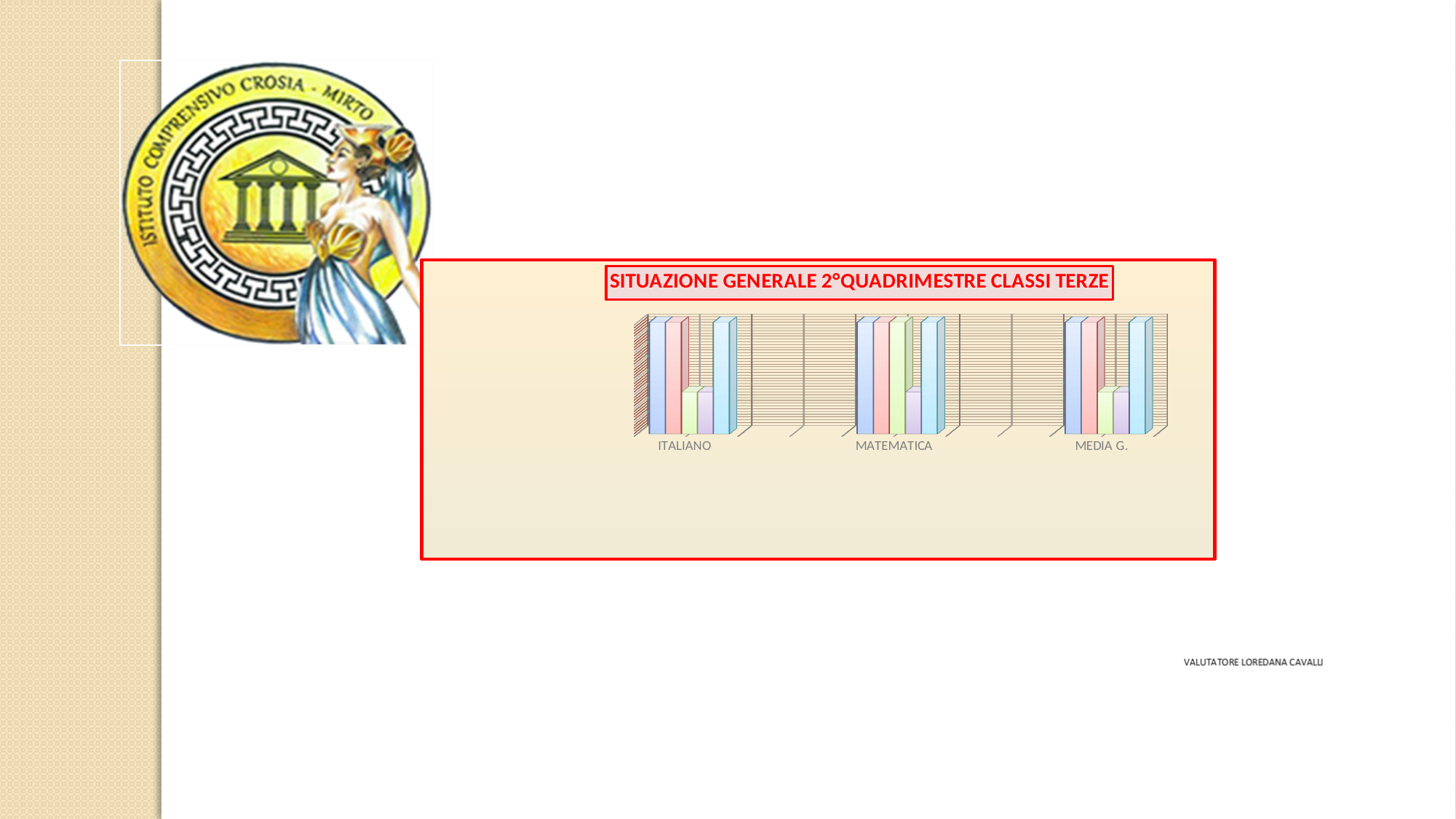
Which category is labelled in the middle of the x axis? MATEMATICA In the MATEMATICA group, is the purple bar taller or shorter than the pink bar? shorter In the MEDIA G. group, is the light blue bar on the right taller or shorter than the green bar? taller How many categories are shown on the x axis of the chart? 3 How many bars are plotted for each category in the chart? 5 What kind of chart is shown on the slide? bar chart In the ITALIANO group, is the green bar taller or shorter than the first blue bar? shorter What is the title of the chart? SITUAZIONE GENERALE 2°QUADRIMESTRE CLASSI TERZE